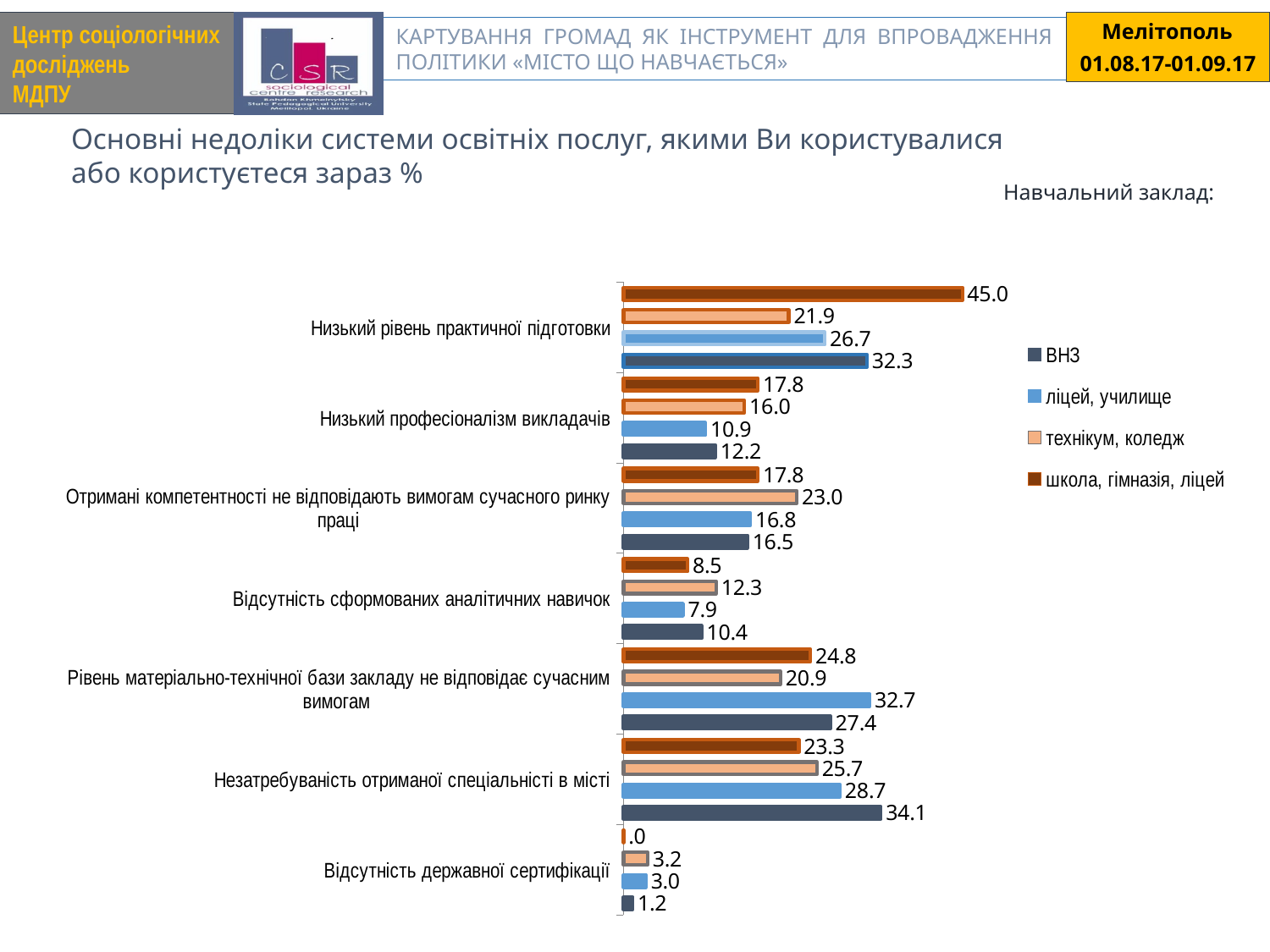
What is the value for "ліцей, училище" in the category "Рівень матеріально-технічної бази закладу не відповідає сучасним вимогам"? 32.7 Which series is shown in the darkest orange colour in the legend? школа, гімназія, ліцей What is the value for "ВНЗ" in the category "Незатребуваність отриманої спеціальності в місті"? 34.1 Which category has the highest value for the "ВНЗ" series? Незатребуваність отриманої спеціальності в місті What is the difference between the "школа, гімназія, ліцей" and "технікум, коледж" values in the category "Низький рівень практичної підготовки"? 23.1 What type of chart is shown on the slide? bar chart What is the value for "школа, гімназія, ліцей" in the category "Низький рівень практичної підготовки"? 45.0 Which category has the lowest value for the "ліцей, училище" series? Відсутність державної сертифікації What is the value for "технікум, коледж" in the category "Отримані компетентності не відповідають вимогам сучасного ринку праці"? 23.0 How many categories are shown on the chart? 7 In the category "Відсутність сформованих аналітичних навичок", which is larger: the value for "технікум, коледж" or for "ліцей, училище"? технікум, коледж How many series does the legend list? 4